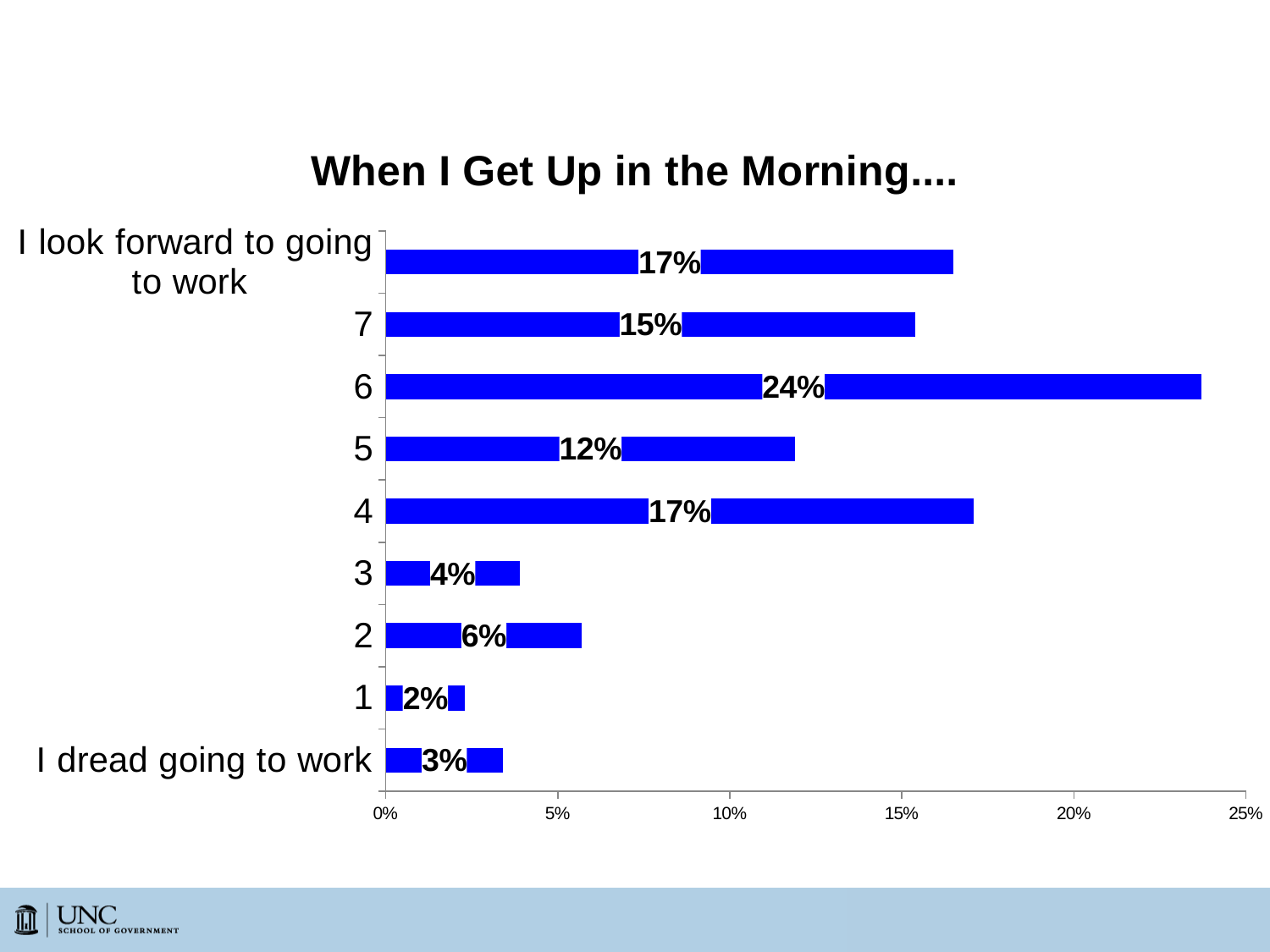
What is the title of the chart? When I Get Up in the Morning.... What is the value for category 3? 4% Which is larger, the value for category 5 or the value for category 2? 5 Which category has the highest value? 6 What is the value for "I dread going to work"? 3% What is the difference between the values for category 6 and category 7? 9% What kind of chart is shown on the slide? bar chart What is the value for category 6? 24% Which category has the lowest value? 1 What is the value for "I look forward to going to work"? 17% Is the value for category 4 greater or less than 15%? greater How many categories are shown in the chart? 9